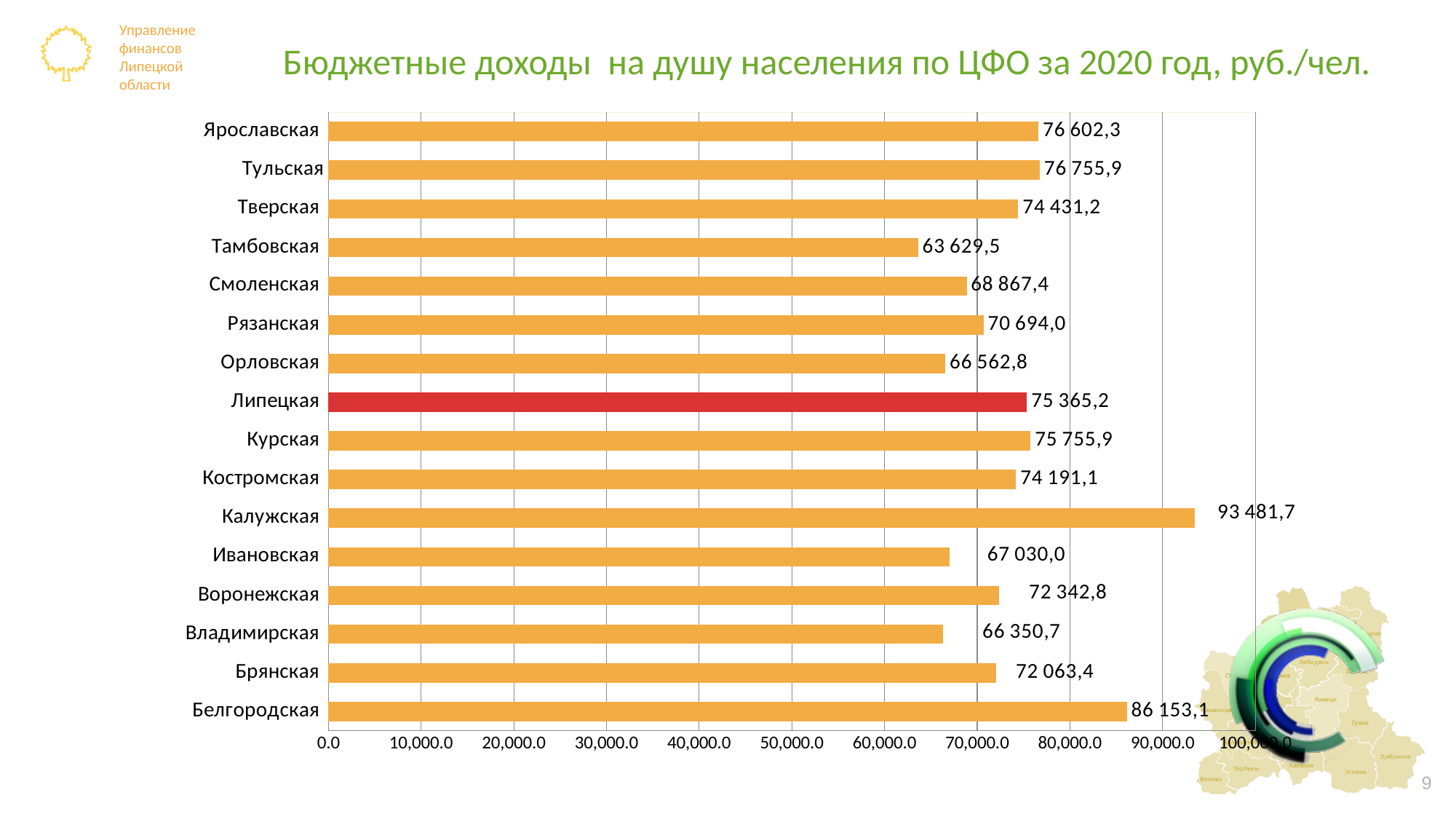
What is the value for Калужская? 93 481,7 What is the value for Тамбовская? 63 629,5 What is the value for Белгородская? 86 153,1 Which region's bar is coloured red instead of orange? Липецкая Which region has the highest value? Калужская What is the difference between the values for Калужская and Белгородская? 7 328,6 What is the value for Липецкая? 75 365,2 Which is larger, the value for Белгородская or the value for Ярославская? Белгородская How many regions are shown in the chart? 16 What kind of chart is shown on the slide? bar chart Is the value for Рязанская greater or less than 70,000.0? greater Which region has the lowest value? Тамбовская